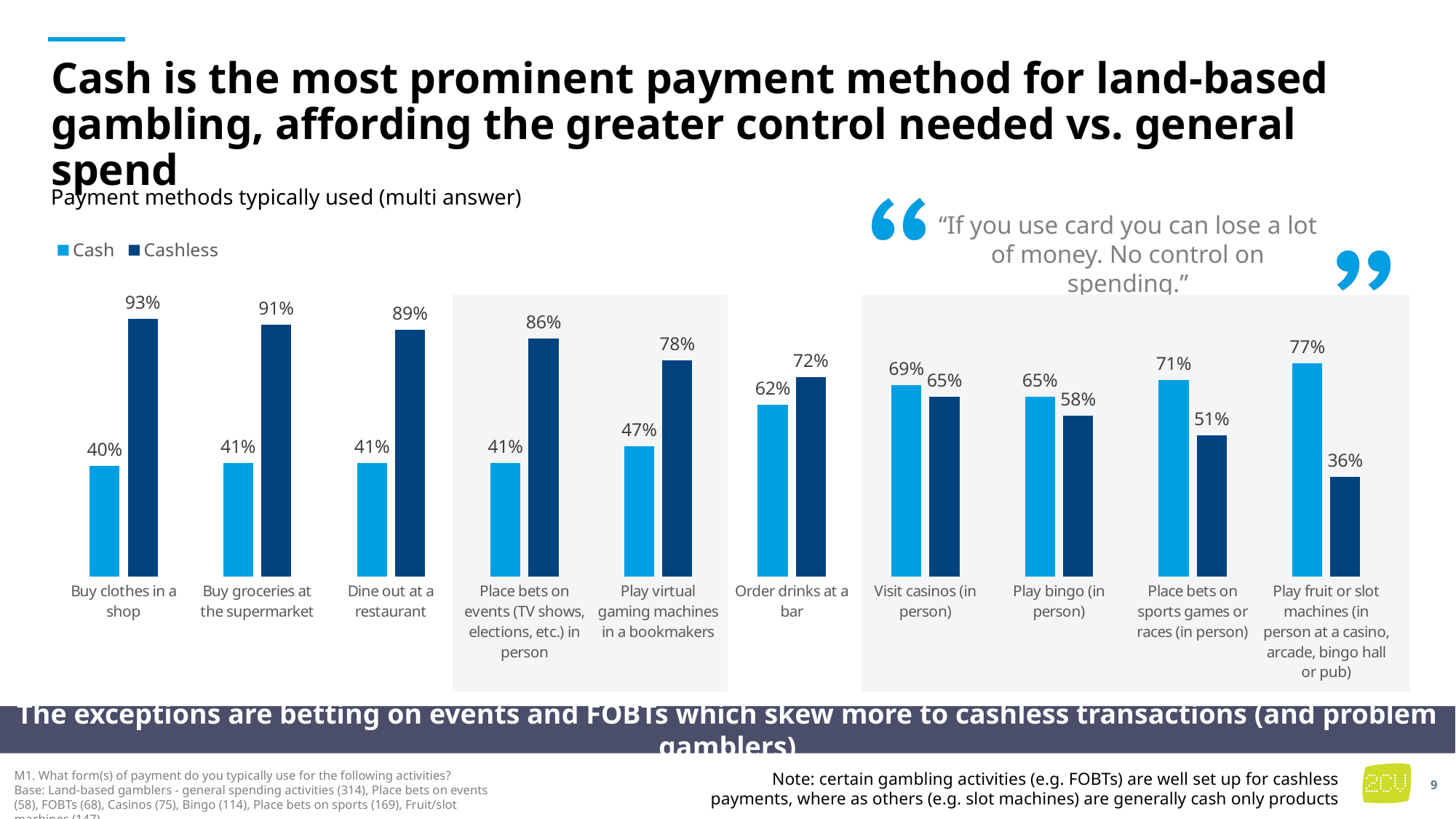
For 'Visit casinos (in person)', which is larger: the Cash value or the Cashless value? Cash What is the Cashless value for 'Buy clothes in a shop'? 93% What is the Cashless value for 'Play virtual gaming machines in a bookmakers'? 78% Which category has the highest Cashless value? Buy clothes in a shop What kind of chart is shown on the slide? Bar chart For 'Order drinks at a bar', which is larger: the Cash value or the Cashless value? Cashless How many series does the chart legend list? 2 What is the difference between the Cashless and Cash values for 'Buy groceries at the supermarket'? 50 percentage points How many categories are shown on the x axis of the chart? 10 Which category has the lowest Cashless value? Play fruit or slot machines (in person at a casino, arcade, bingo hall or pub) What are the two series named in the chart legend? Cash and Cashless What is the Cash value for 'Play fruit or slot machines (in person at a casino, arcade, bingo hall or pub)'? 77%